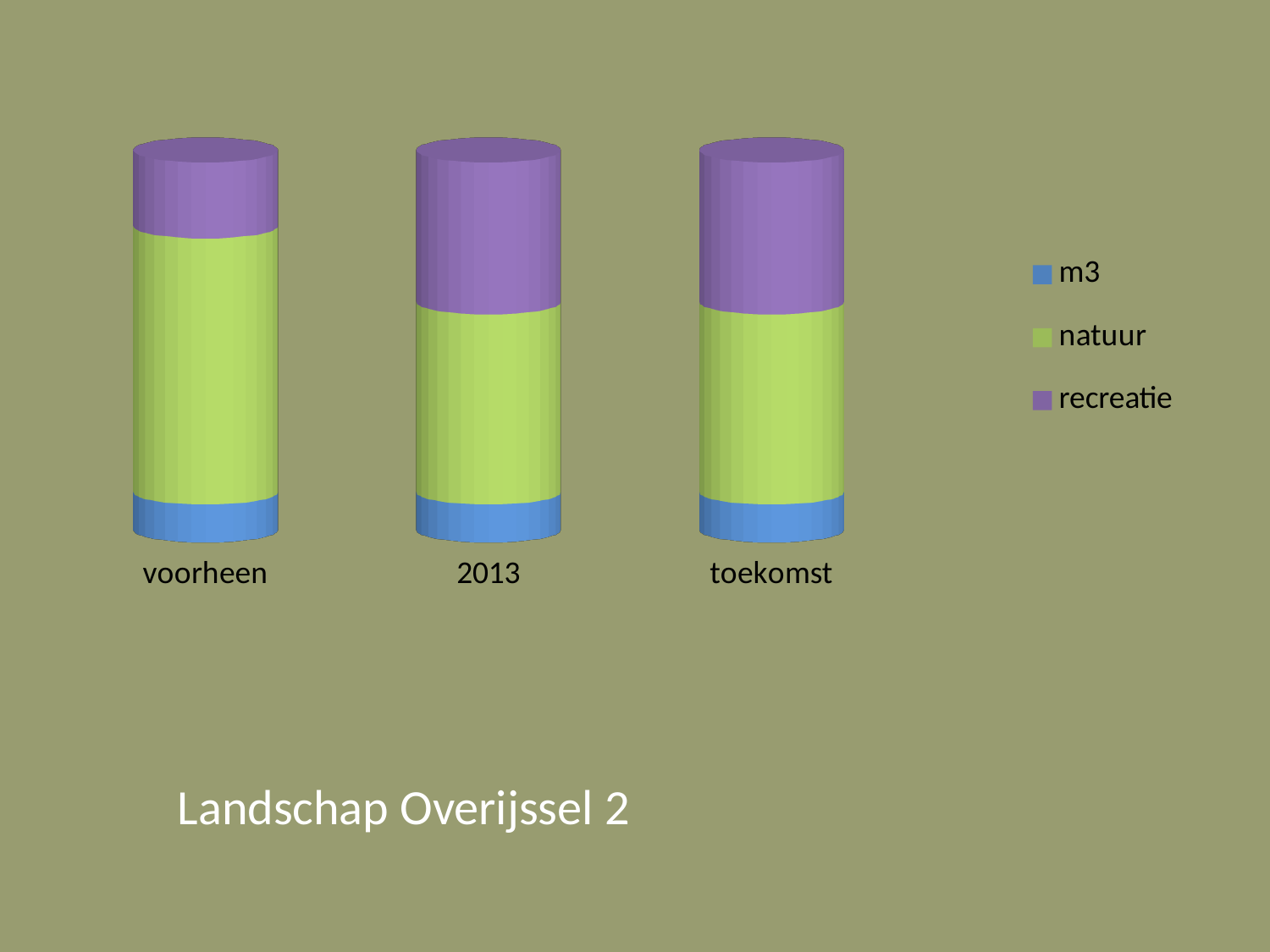
Which series forms the smallest segment in every bar? m3 How many categories are shown along the x axis of the chart? 3 Is the recreatie segment larger for voorheen or for 2013? 2013 How many series does the chart's legend list? 3 Within the voorheen bar, which series takes up the largest share? natuur Does the natuur segment rise or fall from voorheen to 2013? fall Which category has the smallest recreatie segment? voorheen What are the three series listed in the chart's legend? m3, natuur, recreatie Which category has the largest natuur segment? voorheen What are the category labels along the x axis of the chart? voorheen, 2013, toekomst Is the natuur segment larger for voorheen or for toekomst? voorheen What kind of chart is shown on the slide? stacked bar chart